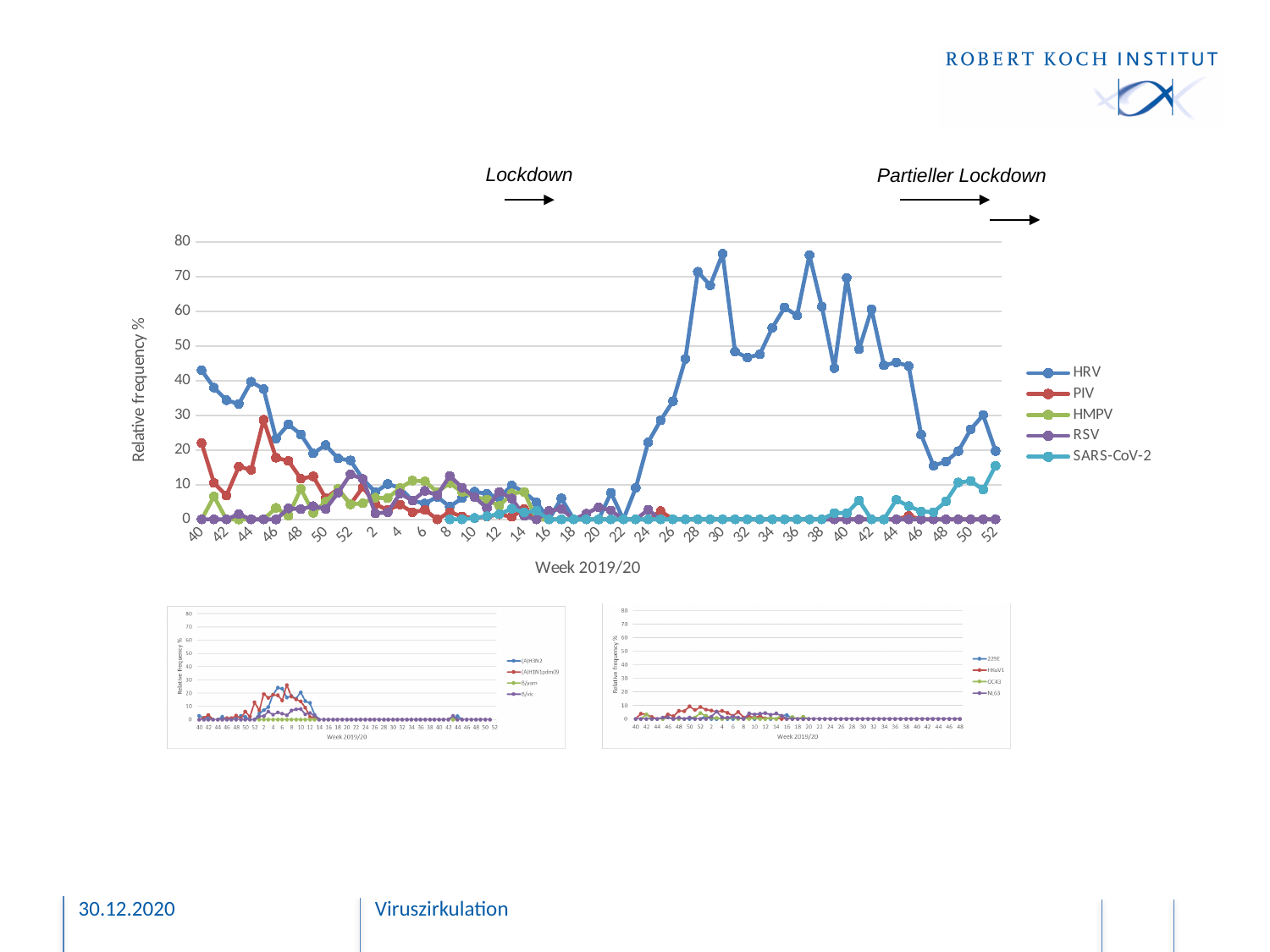
In the main chart, which series reaches the highest relative frequency? HRV In the main chart, which is larger at week 30 of 2020: HRV or SARS-CoV-2? HRV In the main chart, is the peak value of HRV around week 30 of 2020 greater or less than 70? greater How many series does the legend of the main chart list? 5 In the main chart, is the value for SARS-CoV-2 at week 52 of 2020 greater or less than 10? greater What is the label of the y-axis of the main chart? Relative frequency % In the main chart, does the HRV line rise or fall between week 22 and week 30 of 2020? rise What type of chart is the main chart on the slide? line chart What two annotations with arrows are written above the main chart? Lockdown and Partieller Lockdown In the main chart, which is larger at week 40 of 2019: HRV or PIV? HRV In the main chart, is the highest value of PIV greater or less than 20? greater